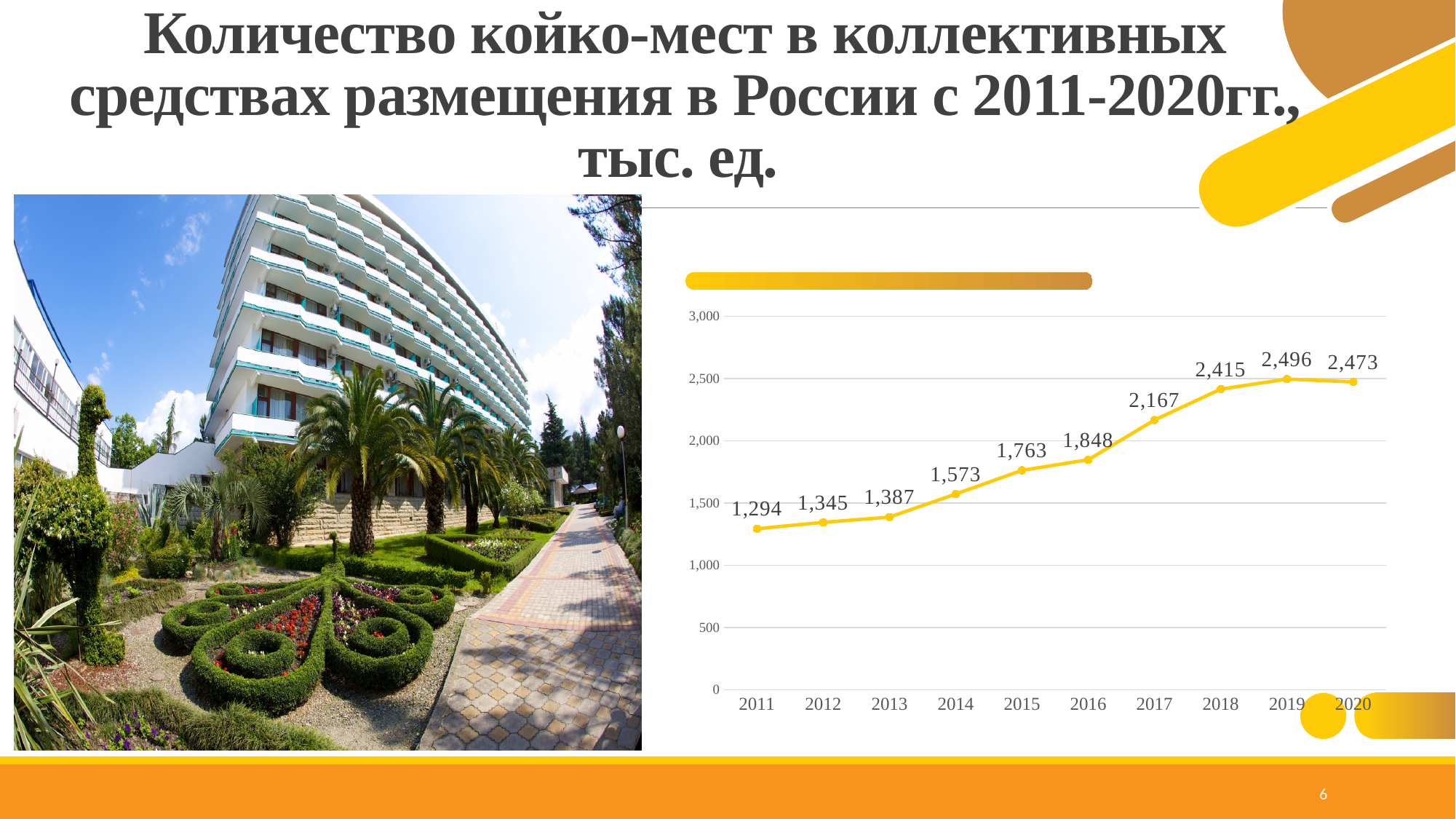
What is the value for 2020? 2,473 What is the value for 2011? 1,294 What is the difference between the values for 2019 and 2018? 81 How many years are plotted on the chart? 10 Is the value for 2014 greater or less than 1,500? greater Do the values generally rise or fall from 2011 to 2019? rise What is the value for 2017? 2,167 What is the difference between the values for 2020 and 2011? 1,179 Which year has the highest value? 2019 Which is larger, the value for 2016 or the value for 2015? 2016 What kind of chart is shown on the slide? line chart Which year has the lowest value? 2011